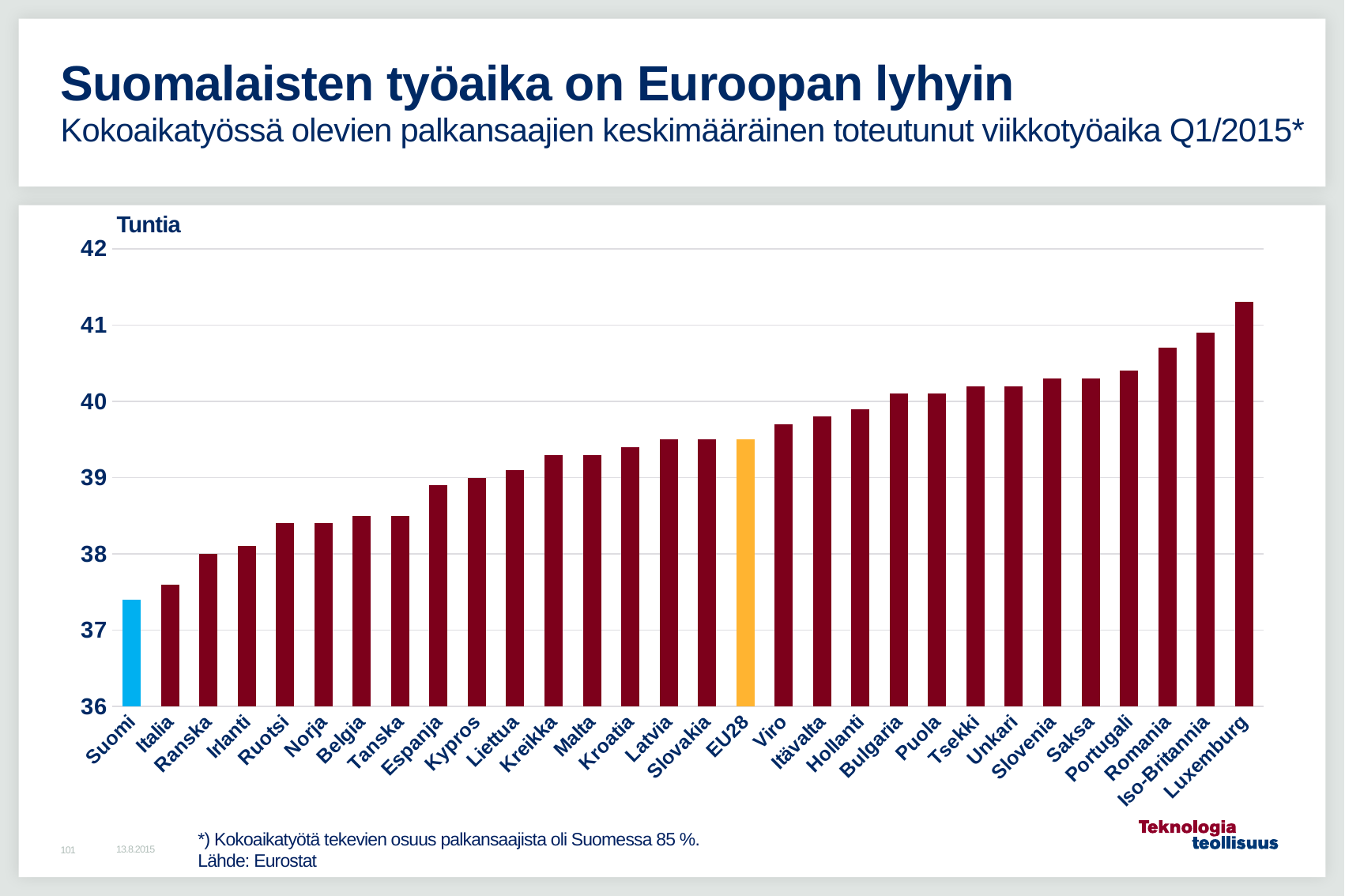
Do the bar values rise or fall from left to right along the x axis? rise Is the value for Saksa greater or less than 40? greater What colour is the bar for Suomi? blue Which country has the lowest average weekly working time in the chart? Suomi Is the value for Espanja greater or less than 39? less Is the value for Suomi greater or less than 38? less What unit label is shown at the top of the vertical axis? Tuntia What kind of chart is shown on the slide? bar chart Which has a larger value, Luxemburg or Suomi? Luxemburg How many bars (categories) are plotted in the chart? 30 Which country has the highest average weekly working time in the chart? Luxemburg